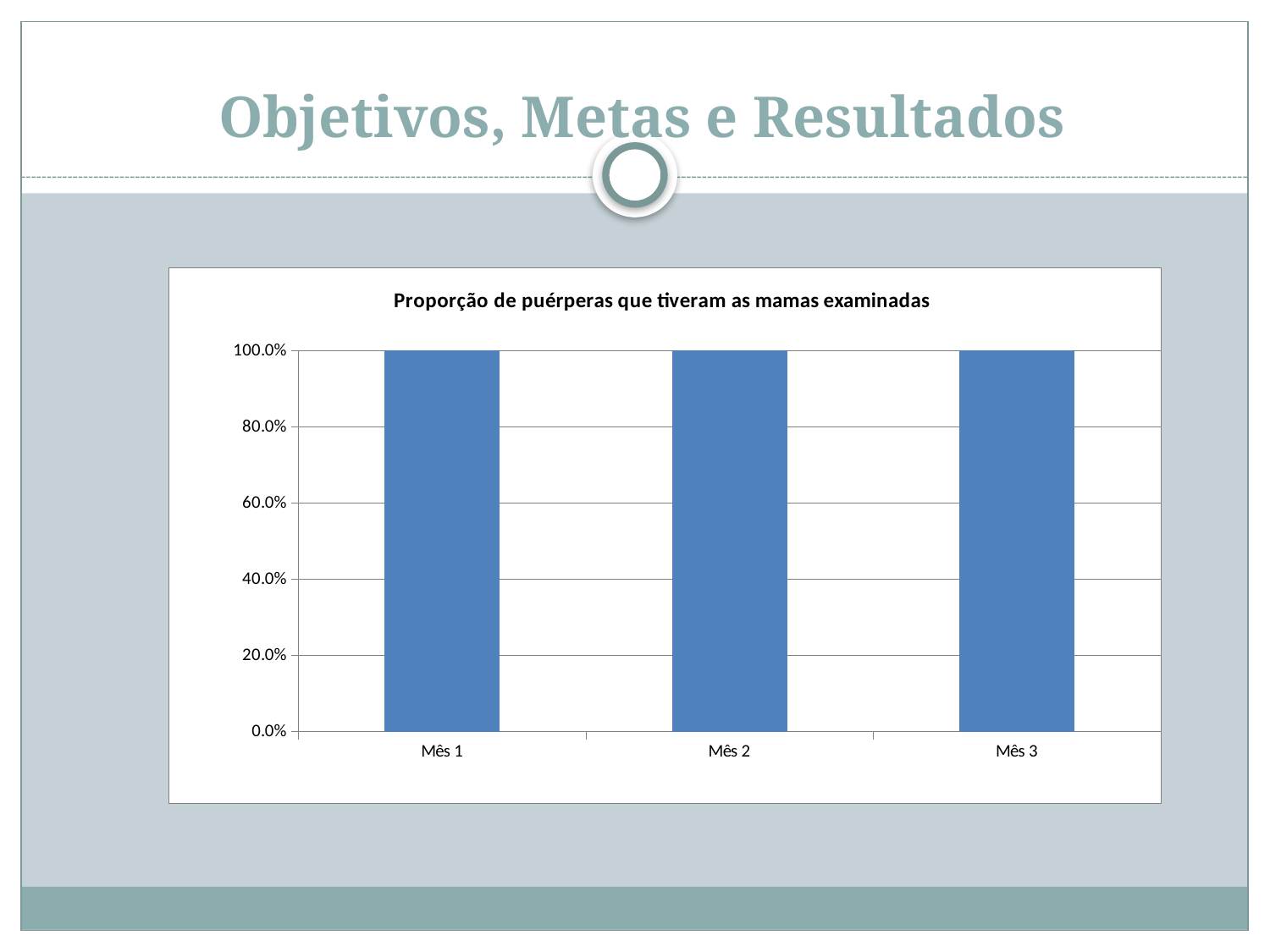
Is the value for Mês 3 greater or less than 60.0%? greater Is the value for Mês 2 greater or less than 80.0%? greater What is the difference between the values for Mês 1 and Mês 3? 0.0% Is the value for Mês 1 larger than, smaller than, or equal to the value for Mês 2? Equal What kind of chart is shown on the slide? Bar chart What is the value for Mês 2? 100.0% How many categories are shown on the x axis? 3 What colour are the bars in the chart? Blue What is the value for Mês 3? 100.0% What is the value for Mês 1? 100.0% What is the title of the chart? Proporção de puérperas que tiveram as mamas examinadas Do the values rise, fall or stay the same from Mês 1 to Mês 3? Stay the same